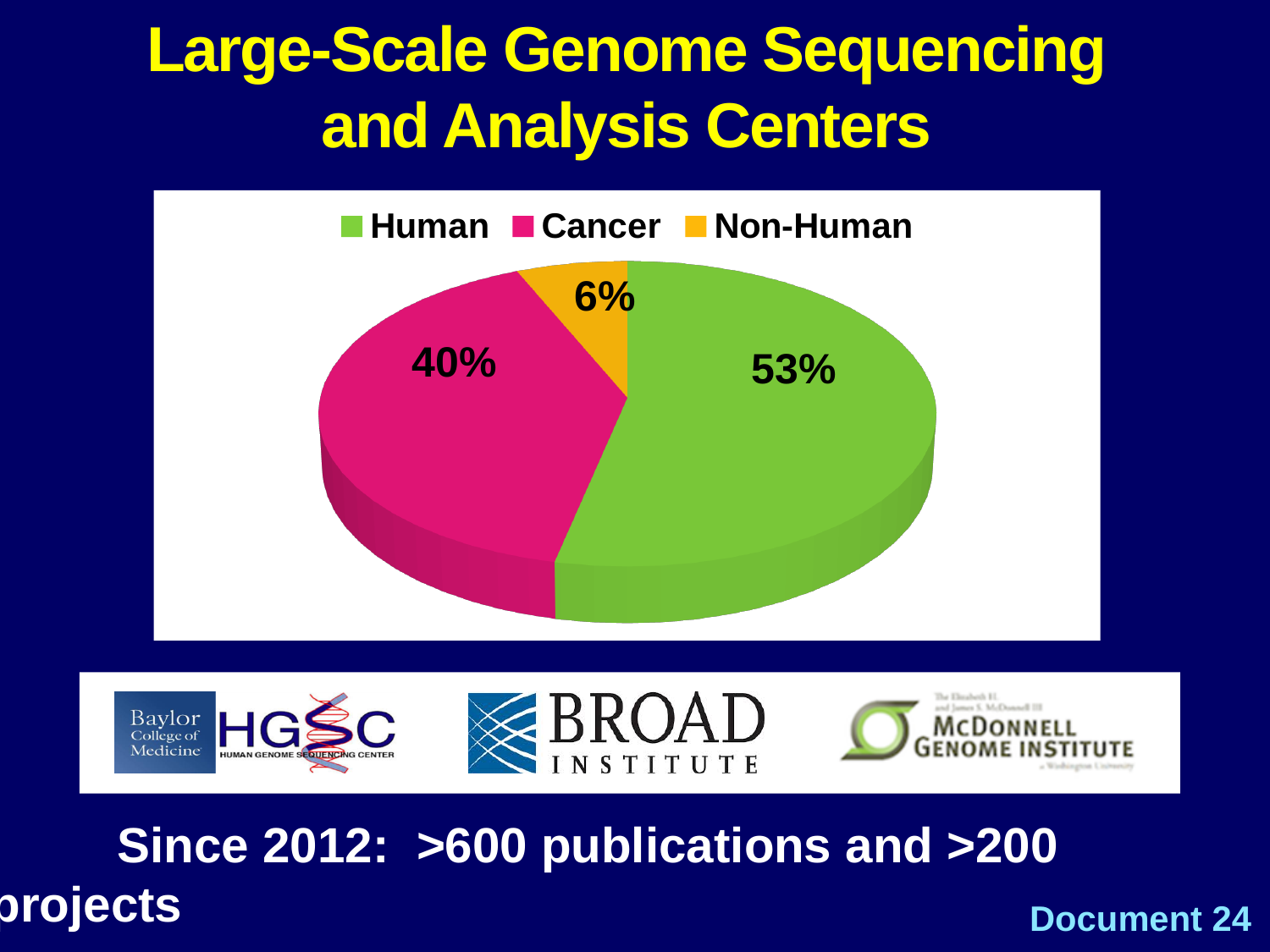
How many entries does the legend list? 3 What colour is the Cancer slice in the pie chart? pink What share of the pie does Non-Human account for? 6% Which category has the largest slice of the pie? Human Which is larger, the Cancer slice or the Non-Human slice? Cancer What share of the pie does Cancer account for? 40% What is the difference in percentage points between the Cancer and Non-Human slices? 34 What is the difference in percentage points between the Human and Cancer slices? 13 How many categories does the pie chart show? 3 What kind of chart is shown on the slide? pie chart Which category has the smallest slice of the pie? Non-Human What share of the pie does Human account for? 53%